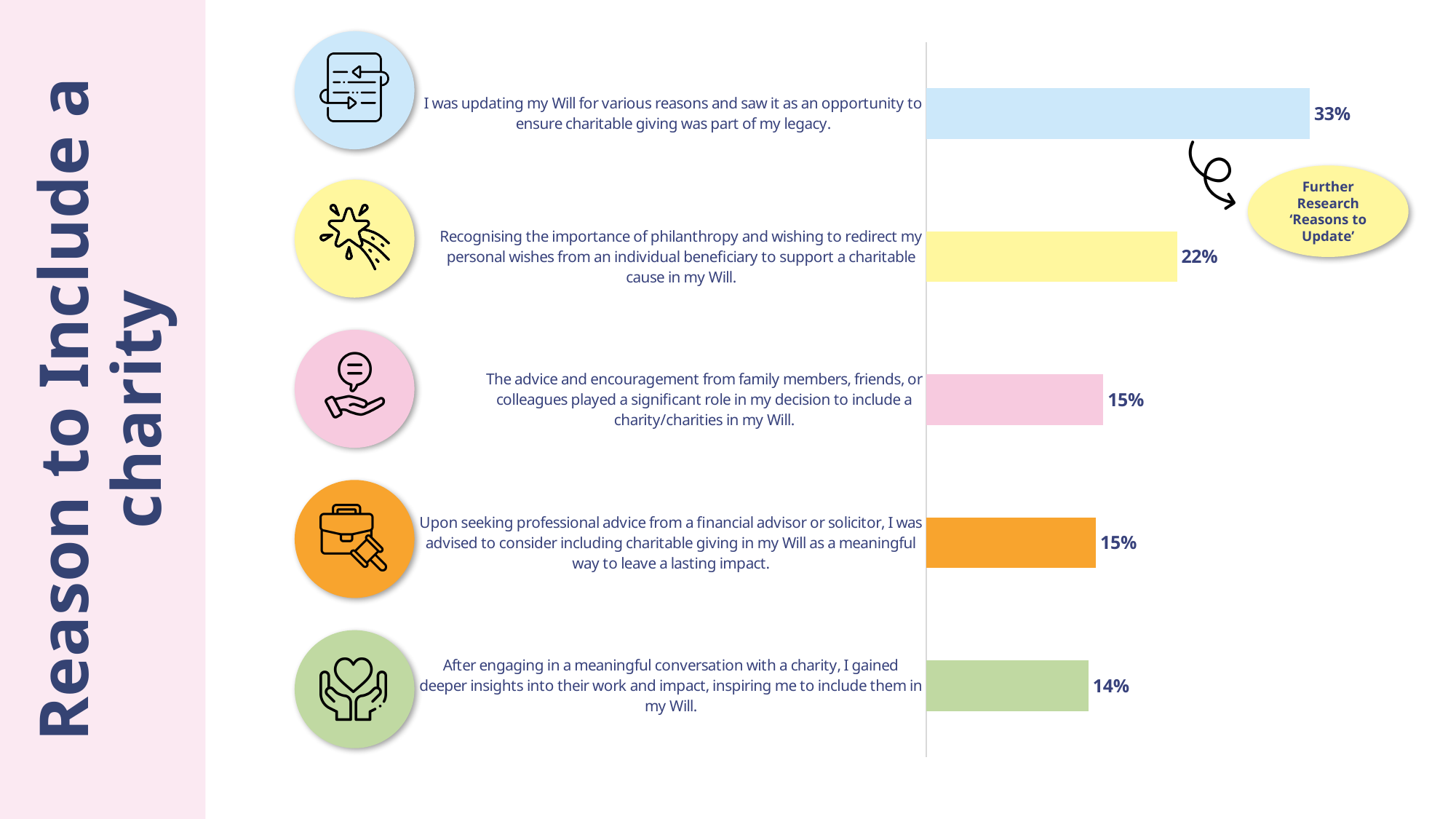
What percentage cited recognising the importance of philanthropy and redirecting wishes from an individual beneficiary to a charitable cause? 22% What type of chart is shown on the slide? Bar chart What percentage said advice and encouragement from family members, friends, or colleagues played a significant role? 15% What is the title of the slide? Reason to Include a charity Which is larger: the percentage for professional advice from a financial advisor or solicitor, or the percentage for a meaningful conversation with a charity? Professional advice from a financial advisor or solicitor What is the difference in percentage points between the 'updating my Will' reason and the 'importance of philanthropy' reason? 11 What does the yellow callout next to the top bar say? Further Research 'Reasons to Update' Which reason for including a charity has the lowest percentage? After engaging in a meaningful conversation with a charity, I gained deeper insights into their work and impact, inspiring me to include them in my Will. Which reason for including a charity has the highest percentage? I was updating my Will for various reasons and saw it as an opportunity to ensure charitable giving was part of my legacy. What percentage of respondents said they were updating their Will for various reasons and saw it as an opportunity to include charitable giving? 33% What percentage said a meaningful conversation with a charity inspired them to include it in their Will? 14% How many reasons for including a charity are shown in the chart? 5